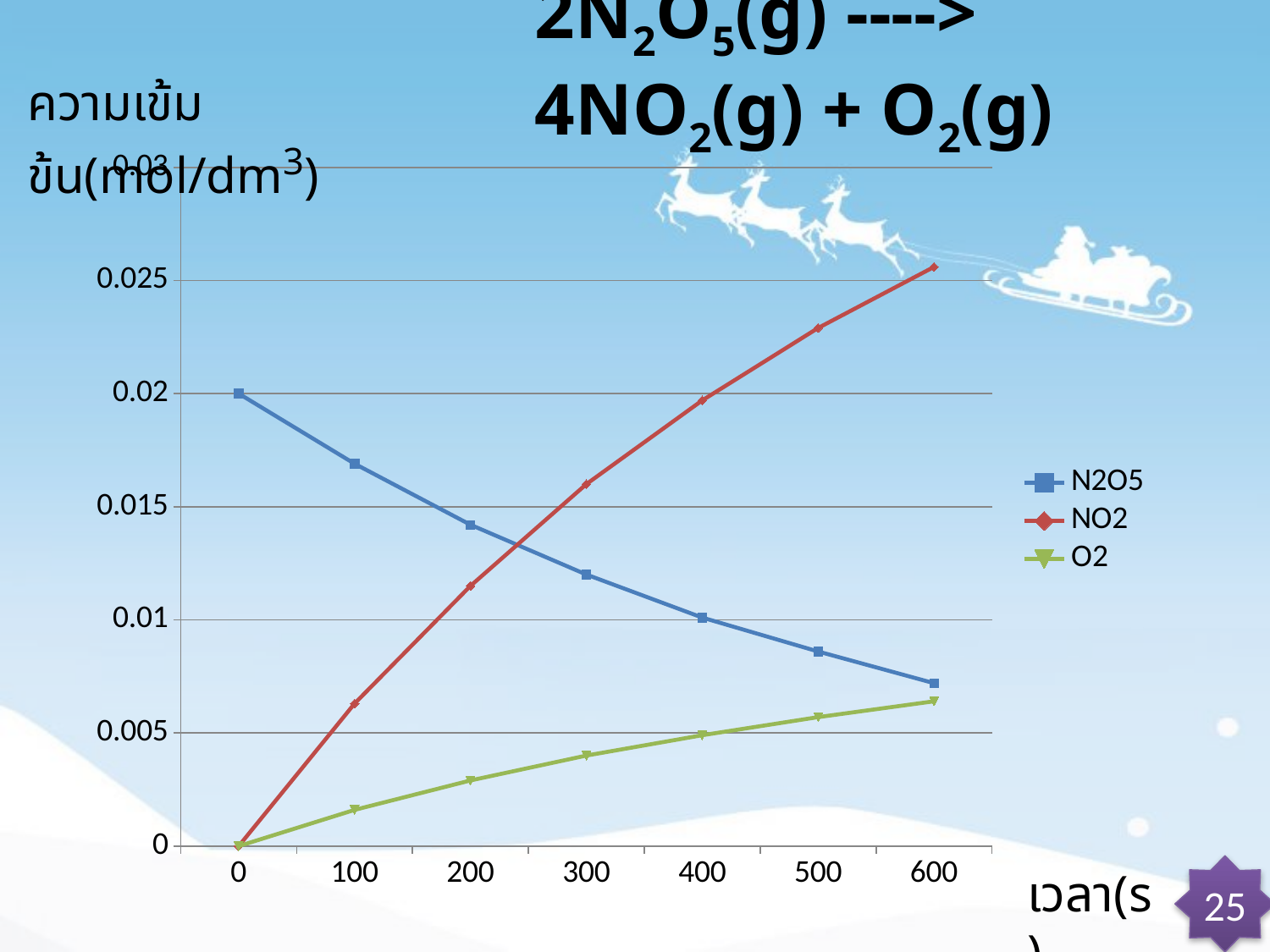
How many series does the legend list? 3 Is the concentration of N2O5 at 600 s greater or less than 0.01? less How many time points are plotted along the x axis for each series? 7 Does the N2O5 concentration rise or fall as time increases? fall Does the NO2 concentration rise or fall as time increases? rise At 300 s, which is larger: the concentration of NO2 or of N2O5? NO2 What kind of chart is shown on the slide? line chart What is the concentration of NO2 at time 0? 0 Which series has the highest concentration at 600 s? NO2 Is the concentration of NO2 at 500 s greater or less than 0.02? greater Which series has the lowest concentration at 600 s? O2 What is the concentration of N2O5 at time 0? 0.02